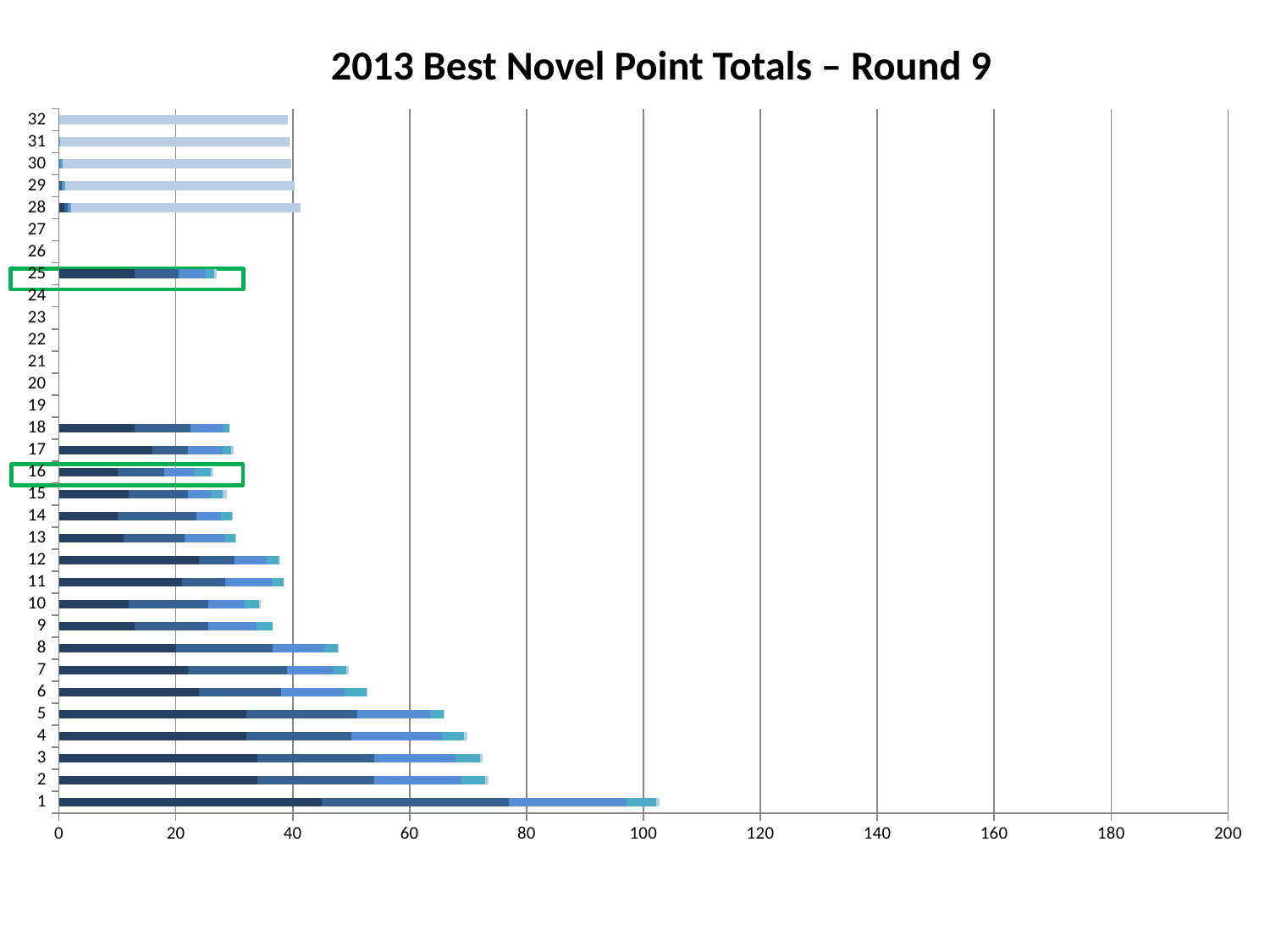
Is the total value for category 1 greater or less than 80? greater How many categories are listed on the vertical axis of the chart? 32 Is the total value for category 8 greater or less than 40? greater Is the total value for category 2 greater or less than 80? less Which has a larger total value, category 1 or category 2? Category 1 What is the title of the chart? 2013 Best Novel Point Totals – Round 9 Which has a larger total value, category 3 or category 6? Category 3 What kind of chart is shown on the slide? Bar chart Which category has the highest total point value? 1 Which two categories are highlighted with green boxes on the chart? 16 and 25